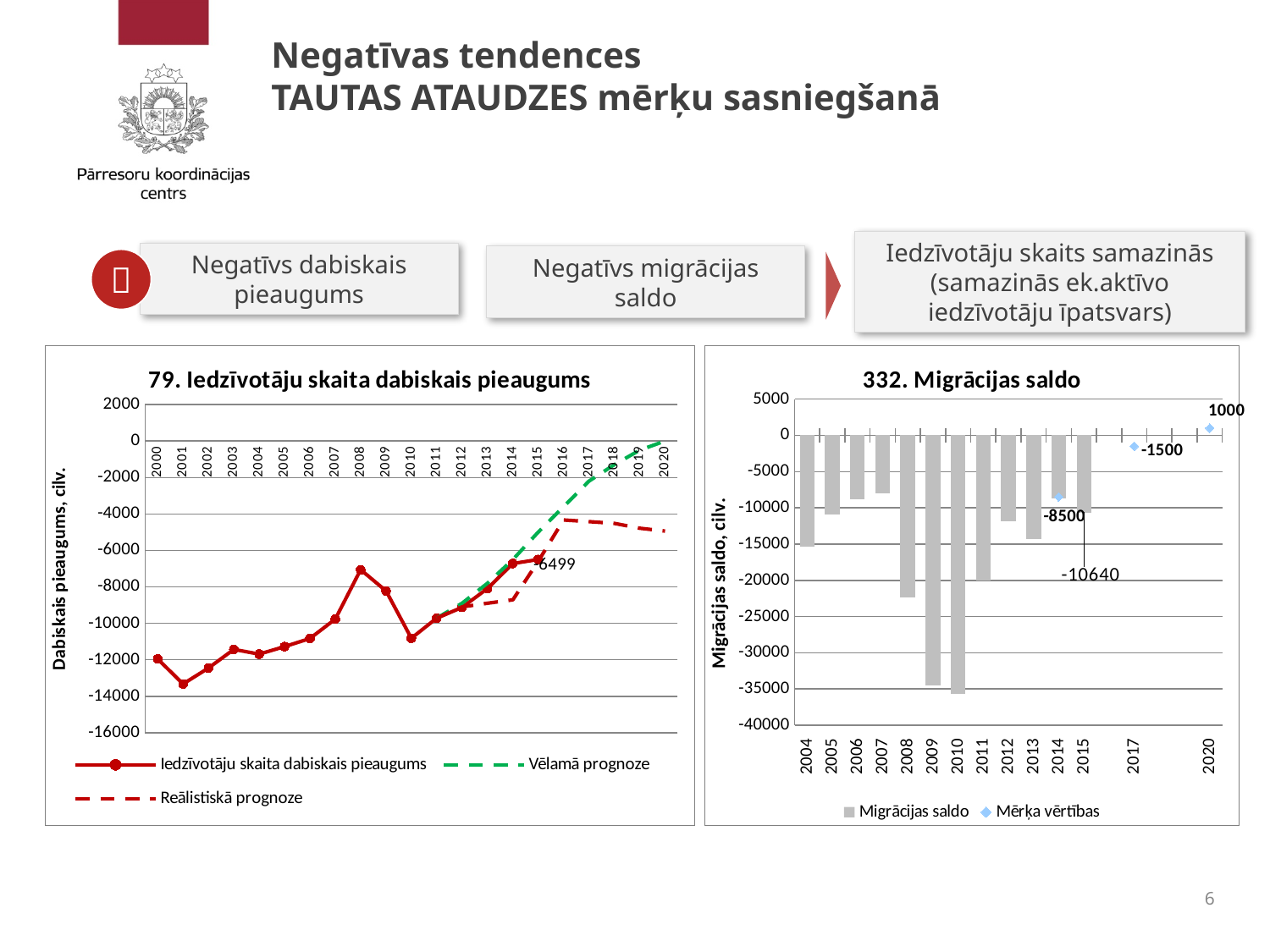
What kind of chart is "332. Migrācijas saldo"? bar chart In "79. Iedzīvotāju skaita dabiskais pieaugums", is the value for 2008 greater or less than -8000? greater In "332. Migrācijas saldo", which is larger, the migration balance for 2004 or for 2005? 2005 How many series does the legend of "79. Iedzīvotāju skaita dabiskais pieaugums" list? 3 In "79. Iedzīvotāju skaita dabiskais pieaugums", what is the labelled value for 2015? -6499 In "332. Migrācijas saldo", what is the difference between the 2020 target value and the 2017 target value? 2500 How many series does the legend of "332. Migrācijas saldo" list? 2 In "332. Migrācijas saldo", what is the target value (Mērķa vērtības) for 2020? 1000 What kind of chart is "79. Iedzīvotāju skaita dabiskais pieaugums"? line chart In "332. Migrācijas saldo", what is the target value (Mērķa vērtības) for 2014? -8500 How many years are shown on the x axis of "332. Migrācijas saldo"? 14 In "332. Migrācijas saldo", what is the target value (Mērķa vērtības) for 2017? -1500